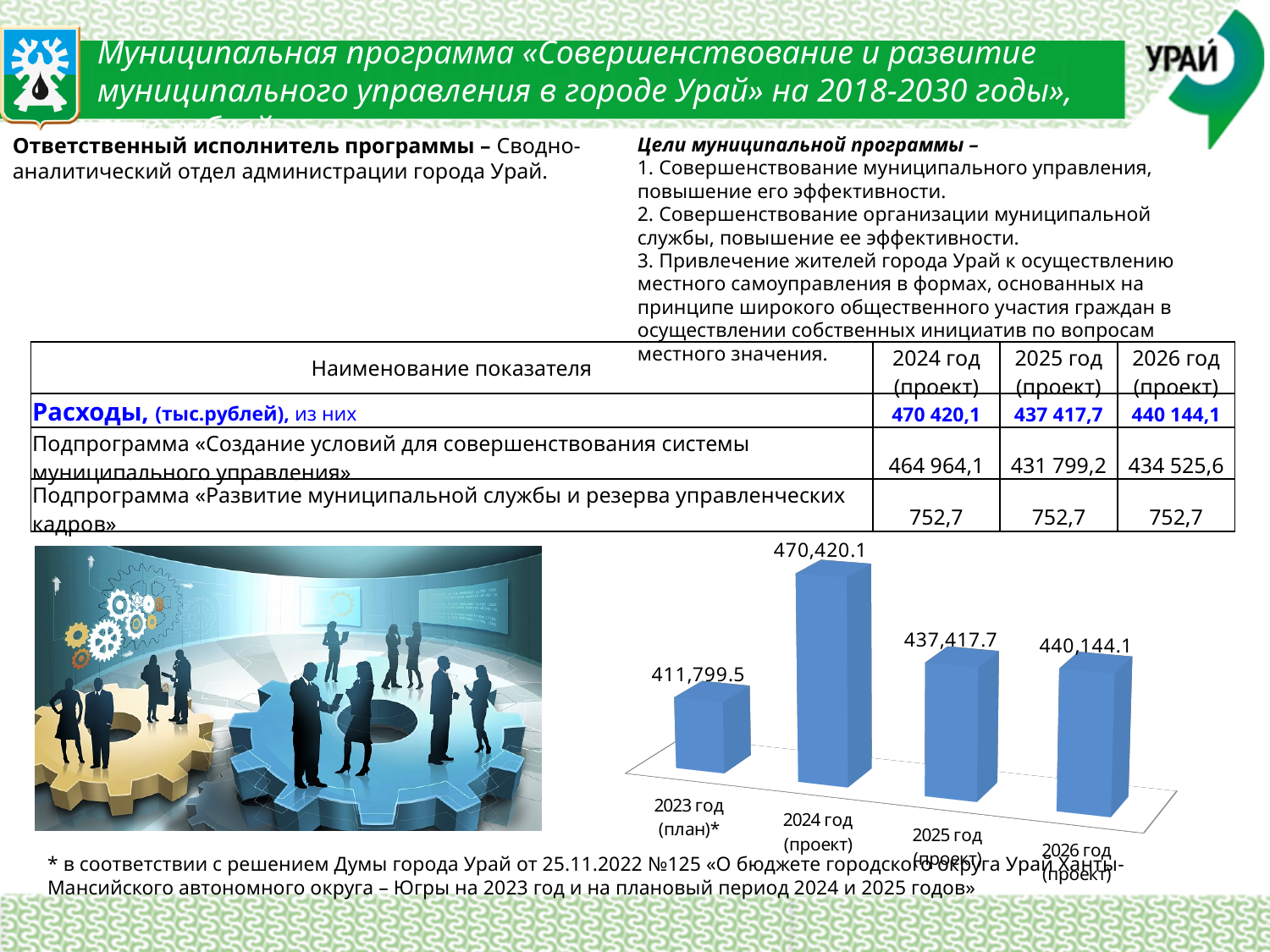
What is the value shown for 2023 год (план)* in the bar chart? 411,799.5 How many bars are plotted in the chart? 4 What is the value shown for 2025 год (проект) in the bar chart? 437,417.7 What is the difference between the values for 2026 год (проект) and 2025 год (проект) in the bar chart? 2,726.4 What is the difference between the values for 2024 год (проект) and 2023 год (план)* in the bar chart? 58,620.6 Which is larger in the bar chart: the value for 2025 год (проект) or 2026 год (проект)? 2026 год (проект) What is the value shown for 2026 год (проект) in the bar chart? 440,144.1 Which year has the lowest value in the bar chart? 2023 год (план)* Which year has the highest value in the bar chart? 2024 год (проект) Does the value rise or fall from 2023 год (план)* to 2024 год (проект) in the bar chart? Rise What kind of chart is shown on the slide? Bar chart What is the value shown for 2024 год (проект) in the bar chart? 470,420.1